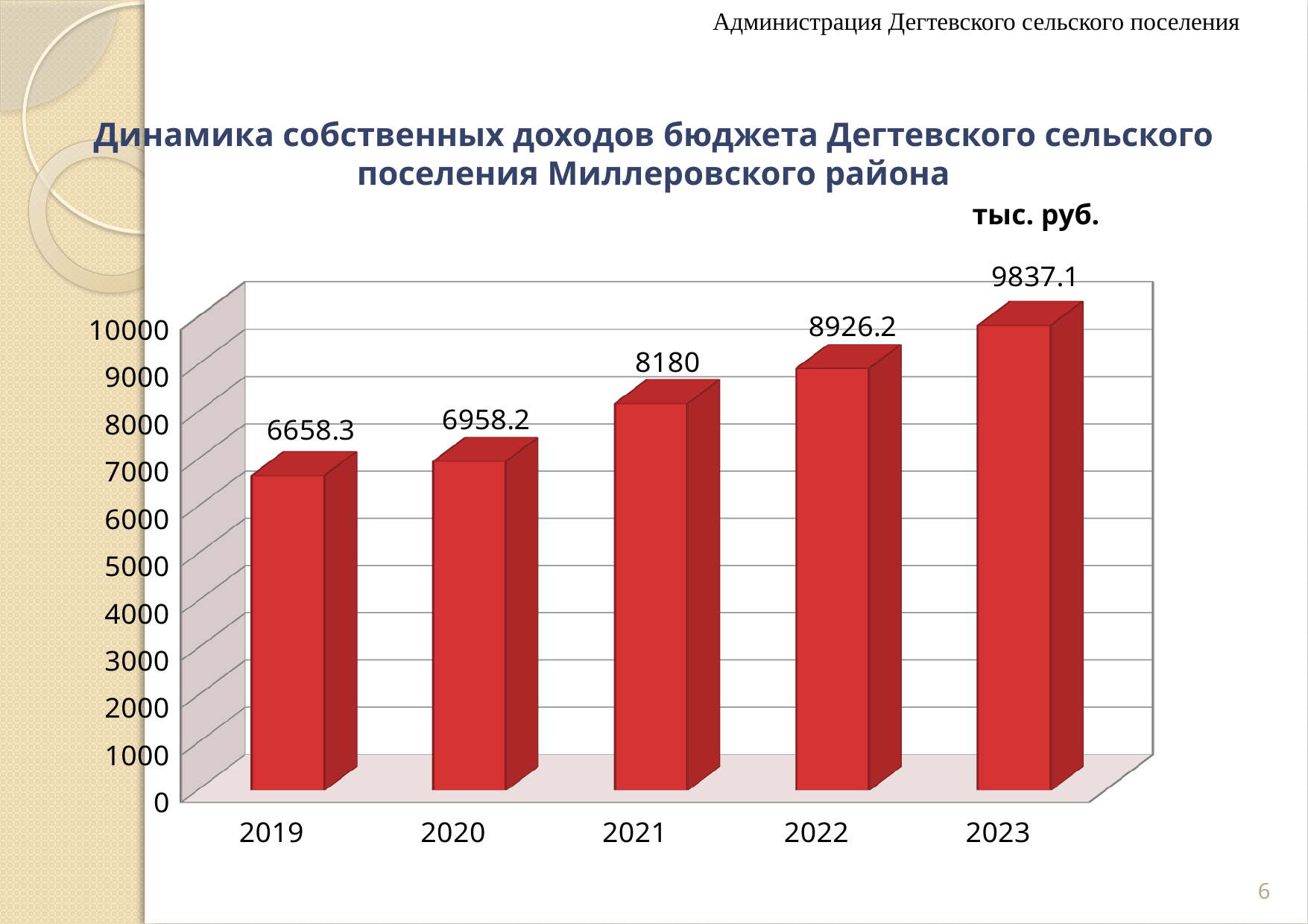
Do the values rise or fall from 2019 to 2023? rise What is the value for 2023? 9837.1 Which year has the lowest value? 2019 What is the difference between the values for 2020 and 2019? 299.9 How many years are shown on the x axis? 5 What is the value for 2021? 8180 Is the value for 2022 greater or less than 8000? greater Which is larger, the value for 2021 or the value for 2020? 2021 What is the difference between the values for 2023 and 2022? 910.9 What kind of chart is shown on the slide? bar chart Which year has the highest value? 2023 What is the value for 2019? 6658.3